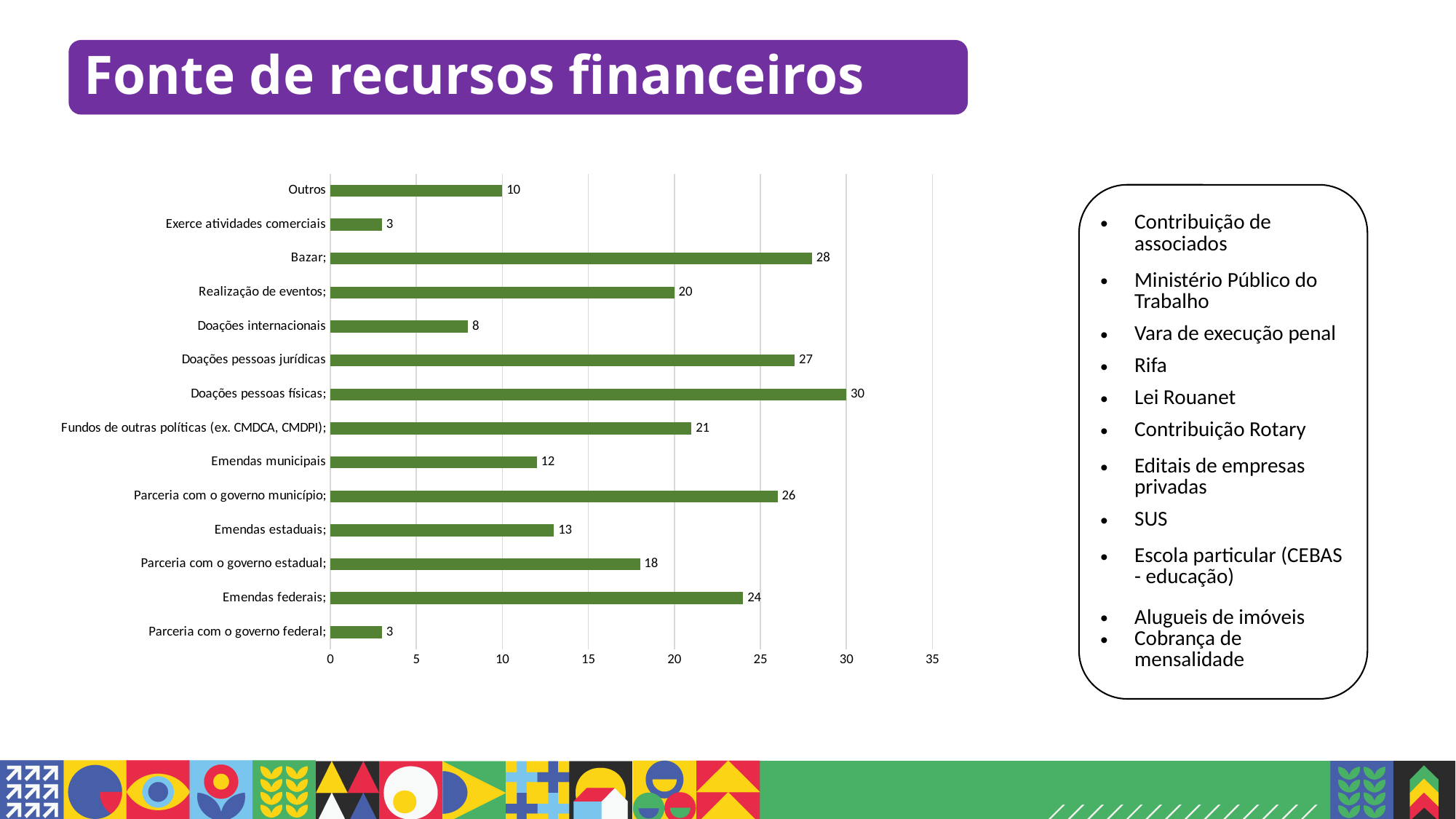
What is the value for Doações pessoas físicas? 30 What is the difference between the values for Bazar and Realização de eventos? 8 How many categories are shown in the chart? 14 What is the value for Bazar? 28 What is the title of the slide containing the chart? Fonte de recursos financeiros Which is larger, the value for Emendas estaduais or the value for Parceria com o governo estadual? Parceria com o governo estadual What type of chart is shown on the slide? Bar chart What is the value for Emendas federais? 24 What is the value for Fundos de outras políticas (ex. CMDCA, CMDPI)? 21 What is the value for Doações internacionais? 8 Which category has the highest value? Doações pessoas físicas What is the difference between the values for Parceria com o governo município and Emendas municipais? 14